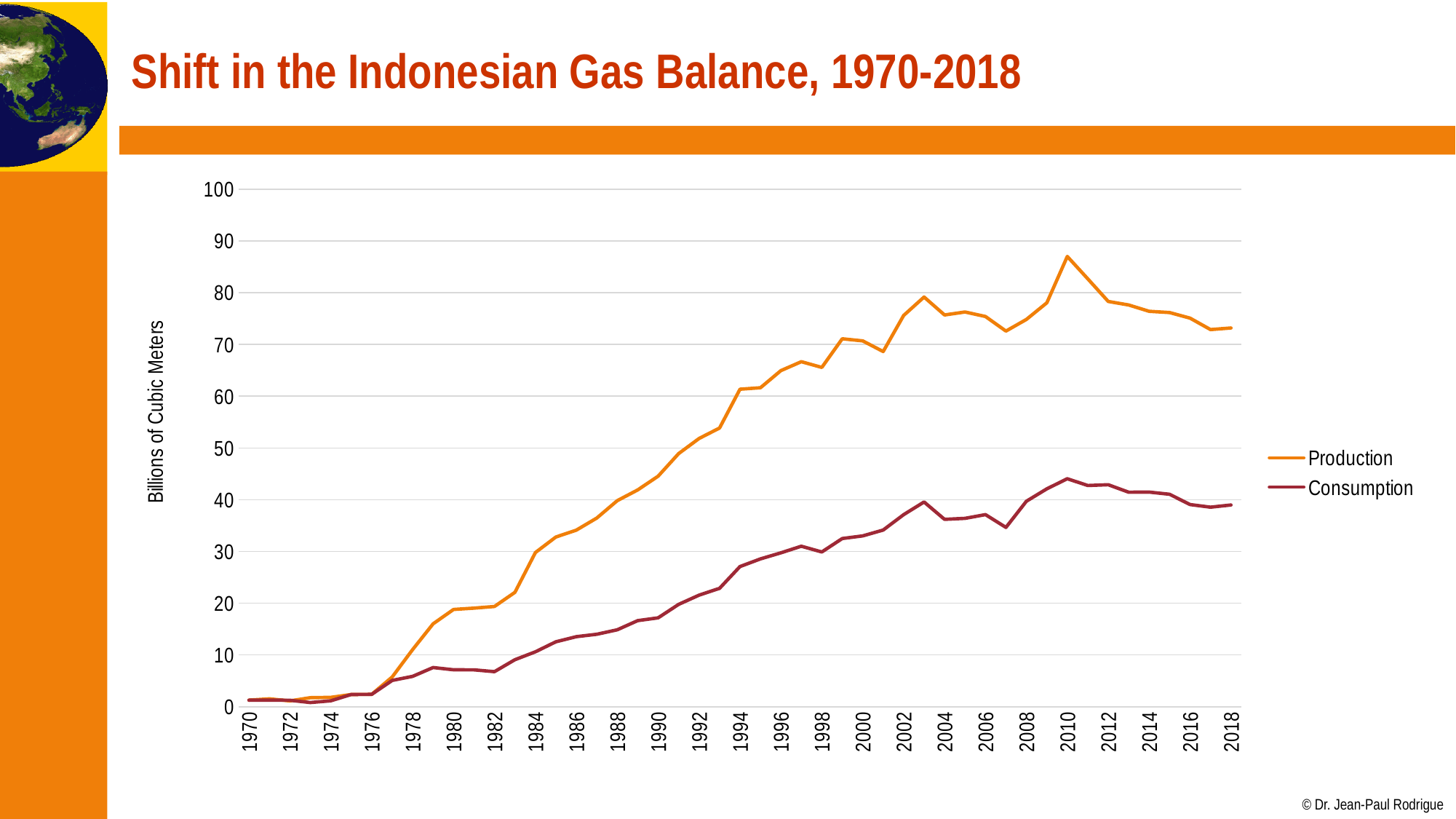
In which year does the Consumption line reach its highest value? 2010 Is the Consumption value in 1990 greater or less than 20? less Does the Production line rise or fall between 2010 and 2018? fall What are the two series named in the legend? Production and Consumption How many series does the legend list? 2 What is the label of the vertical axis? Billions of Cubic Meters Is the Production value in 2018 greater or less than 70? greater In which year does the Production line reach its highest value? 2010 What kind of chart is shown on the slide? line chart Is the Production value in 2010 greater or less than 80? greater In 2000, which series has the larger value, Production or Consumption? Production